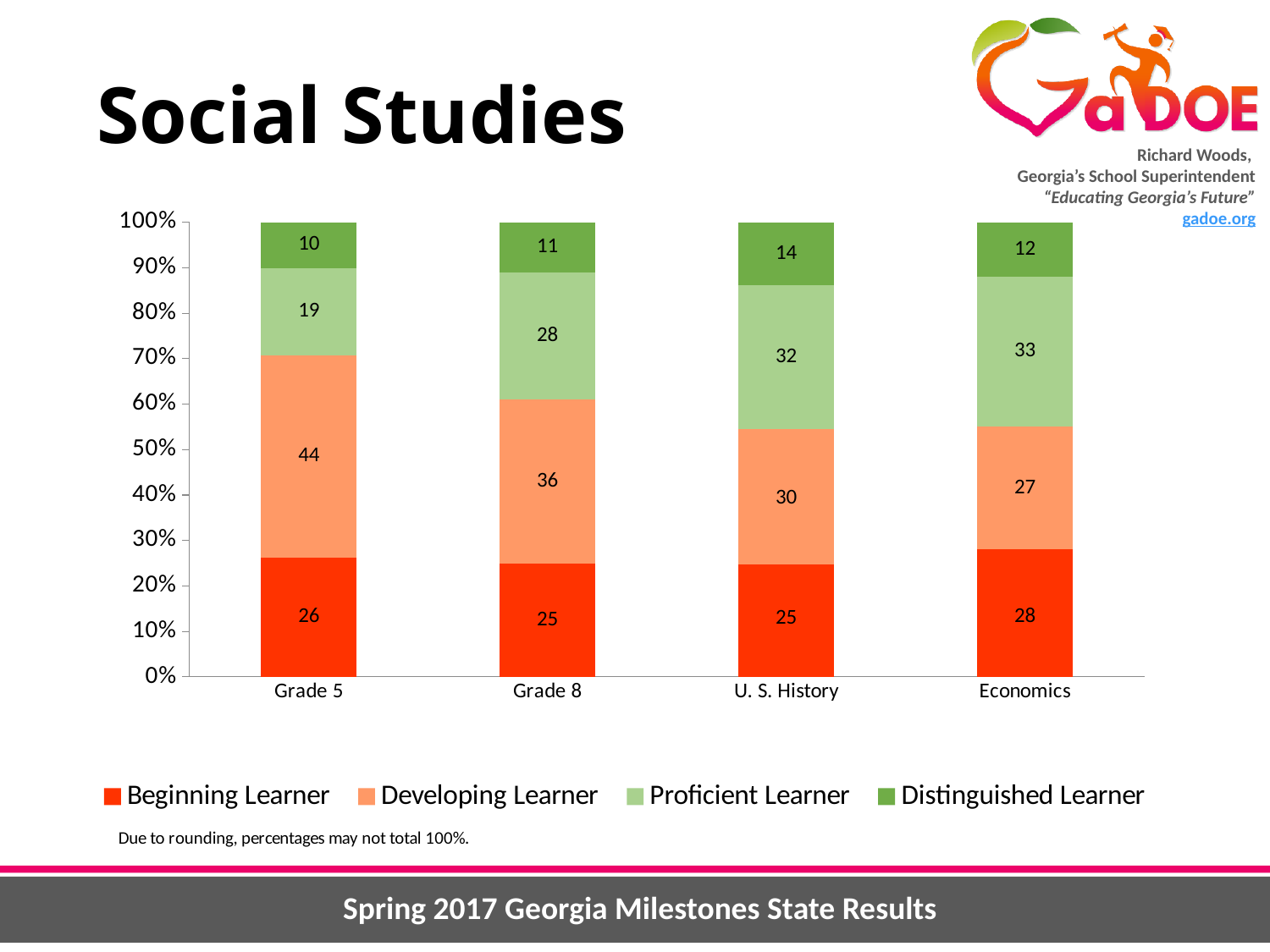
What is the Proficient Learner value for Economics? 33 Which is larger, the Distinguished Learner value for U. S. History or for Economics? U. S. History Which category has the lowest Proficient Learner value? Grade 5 Which legend entry is shown in the darkest green colour? Distinguished Learner What kind of chart is shown on the slide? Stacked bar chart What is the Distinguished Learner value for U. S. History? 14 What is the difference between the Proficient Learner values for Economics and Grade 5? 14 What is the Beginning Learner value for Grade 8? 25 How many categories are shown on the x axis? 4 What is the Developing Learner value for Grade 5? 44 Which category has the highest Developing Learner value? Grade 5 How many series does the legend list? 4